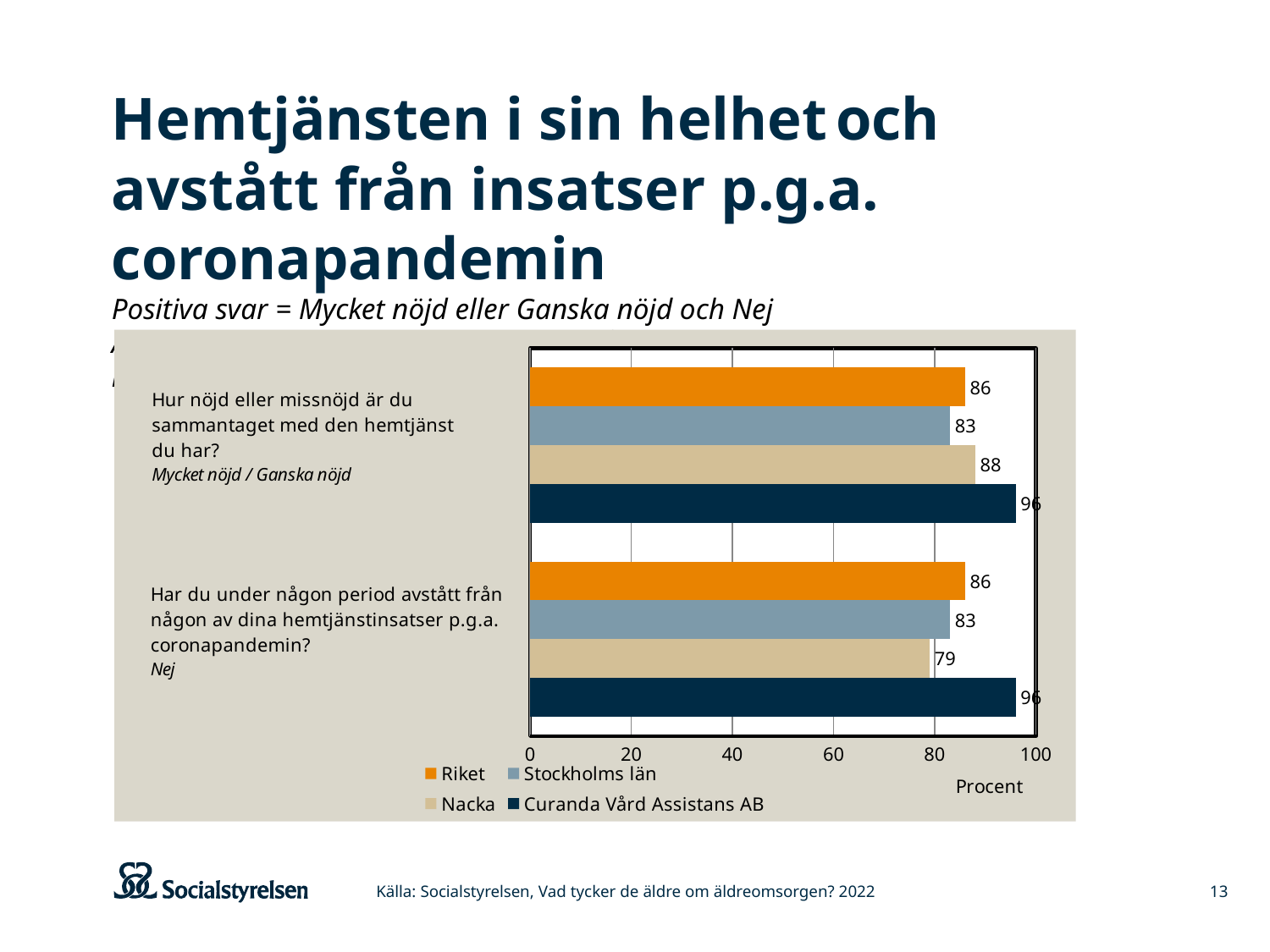
Which is larger on the question 'Hur nöjd eller missnöjd är du sammantaget med den hemtjänst du har?': the value for Riket or the value for Nacka? Nacka Is the value for Nacka on the question 'Har du under någon period avstått från någon av dina hemtjänstinsatser p.g.a. coronapandemin?' greater or less than 80? less What is the value for Riket on the question 'Hur nöjd eller missnöjd är du sammantaget med den hemtjänst du har?' 86 What kind of chart is shown on the slide? bar chart How many series does the legend list? 4 What is the value for Nacka on the question 'Har du under någon period avstått från någon av dina hemtjänstinsatser p.g.a. coronapandemin?' 79 Which series has the lowest value on the question 'Har du under någon period avstått från någon av dina hemtjänstinsatser p.g.a. coronapandemin?' Nacka What label is shown on the horizontal axis of the chart? Procent What is the value for Stockholms län on the question 'Hur nöjd eller missnöjd är du sammantaget med den hemtjänst du har?' 83 Which series has the highest value on the question 'Har du under någon period avstått från någon av dina hemtjänstinsatser p.g.a. coronapandemin?' Curanda Vård Assistans AB What is the difference between the Nacka value and the Stockholms län value on the question 'Hur nöjd eller missnöjd är du sammantaget med den hemtjänst du har?' 5 What is the value for Nacka on the question 'Hur nöjd eller missnöjd är du sammantaget med den hemtjänst du har?' 88